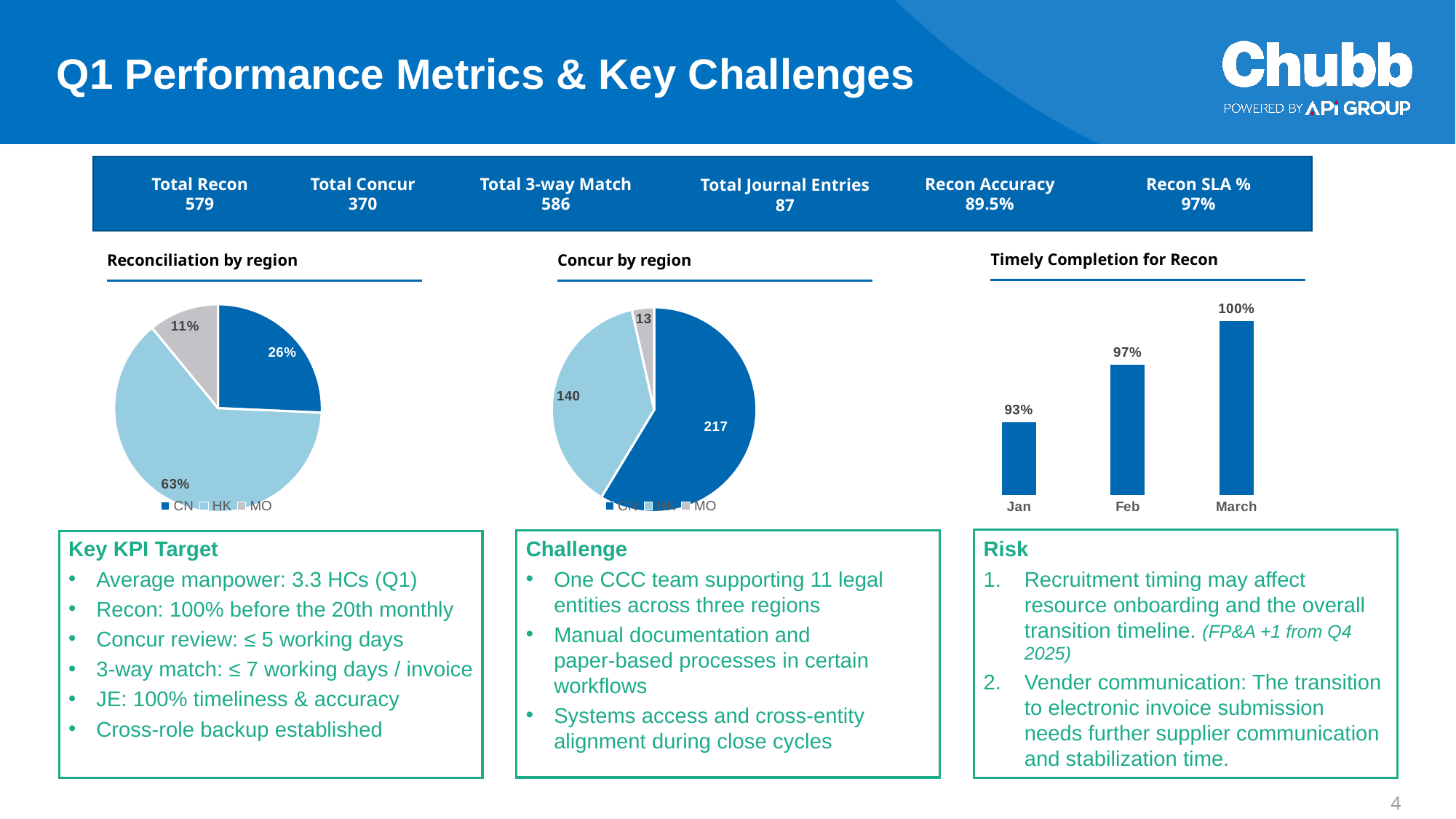
In the "Concur by region" chart, what is the value for HK? 140 In the "Timely Completion for Recon" chart, what is the value for Feb? 97% In the "Reconciliation by region" chart, what share does HK have? 63% In the "Concur by region" chart, what is the difference between the CN and HK values? 77 In the "Concur by region" chart, what is the value for CN? 217 In the "Reconciliation by region" chart, which region has the smallest share? MO In the "Reconciliation by region" chart, what share does MO have? 11% In the "Reconciliation by region" chart, which region has the largest share? HK In the "Timely Completion for Recon" chart, what is the difference between the March and Jan values? 7% In the "Concur by region" chart, which region has the smallest value? MO What kind of chart is "Timely Completion for Recon"? bar chart In the "Timely Completion for Recon" chart, do the values rise or fall from Jan to March? rise